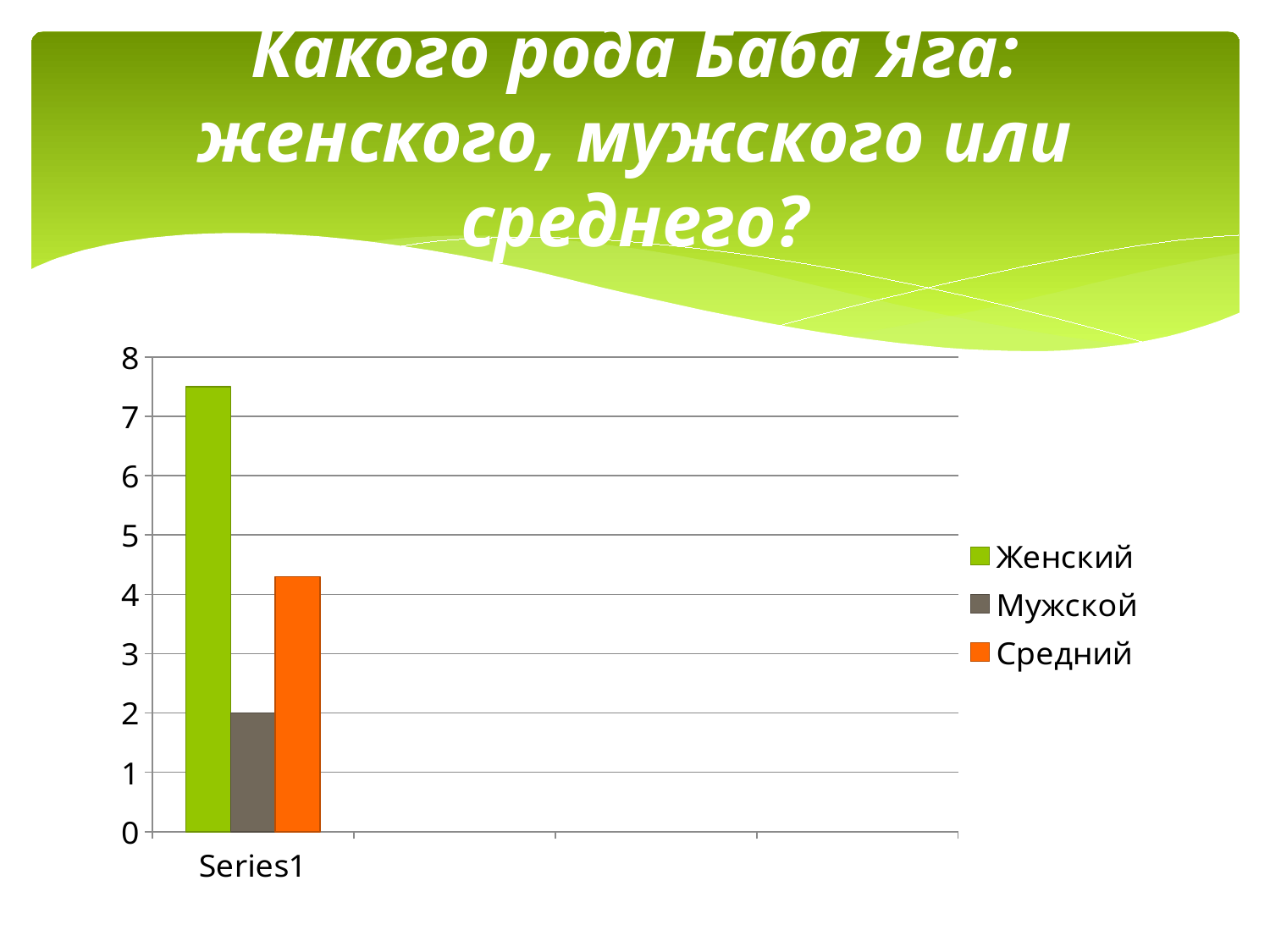
What kind of chart is shown on the slide? bar chart Which is larger, the value for Женский or the value for Средний? Женский Which series has the highest bar? Женский How many series does the legend list? 3 What is the label of the category on the x axis? Series1 What is the value for Мужской? 2 Is the value for Женский greater or less than 7? greater Which series has the lowest bar? Мужской Is the value for Средний greater or less than 4? greater What colour is the bar for Средний? orange Is the value for Средний greater or less than 5? less Which is larger, the value for Средний or the value for Мужской? Средний